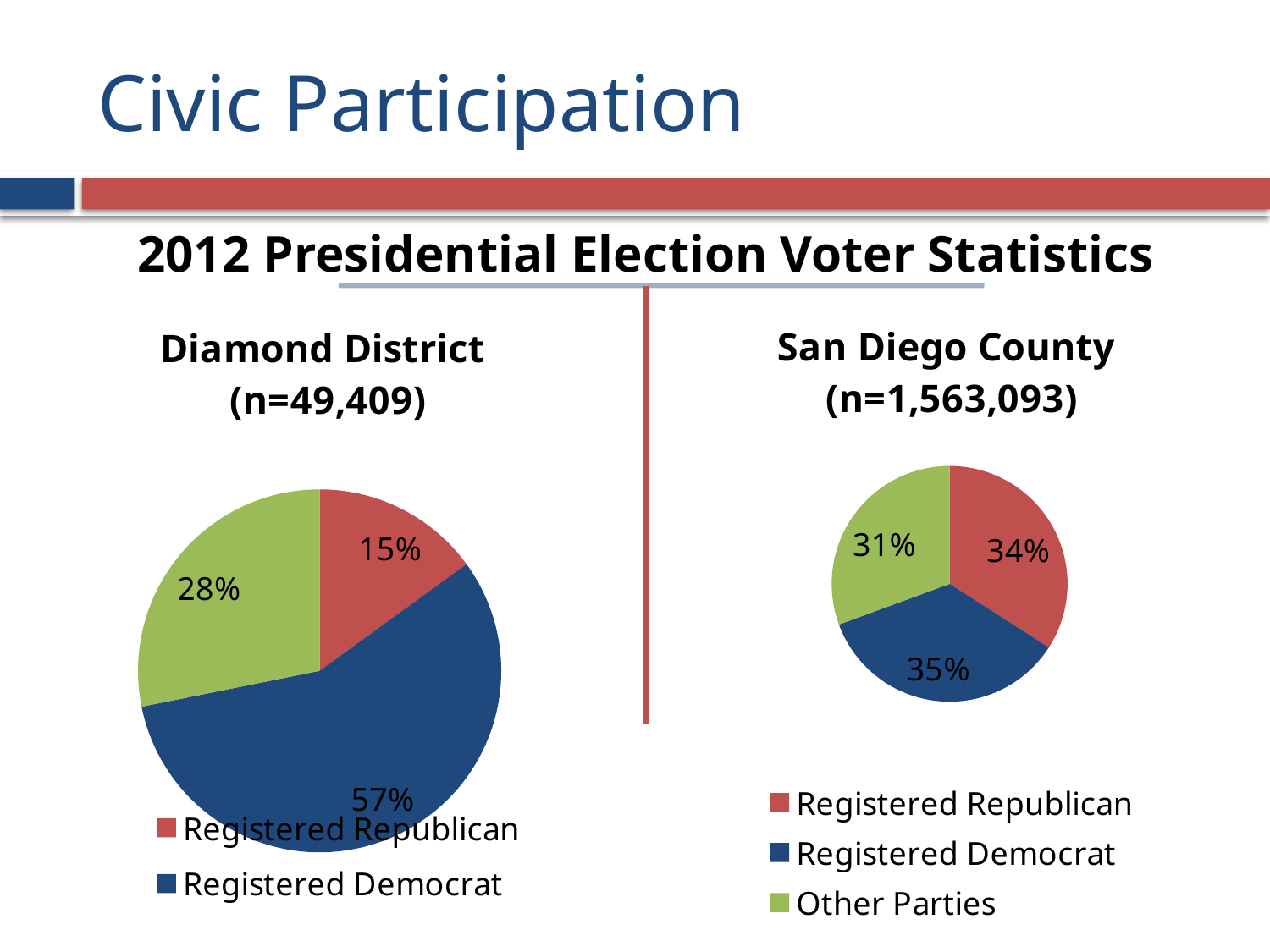
In the Diamond District pie chart, what is the difference in percentage points between Registered Democrat and Registered Republican? 42 What type of chart is used for the San Diego County data? Pie chart In the Diamond District pie chart, what share of voters are Registered Republican? 15% How many entries does the legend of the San Diego County chart list? 3 In the Diamond District pie chart, what share of voters are Registered Democrat? 57% In the San Diego County pie chart, what is the difference in percentage points between Registered Democrat and Other Parties? 4 In the Diamond District pie chart, which category has the smallest slice? Registered Republican In the San Diego County pie chart, what share of voters are Registered Republican? 34% In the San Diego County pie chart, what share of voters are Registered Democrat? 35% In the Diamond District pie chart, which category has the largest slice? Registered Democrat Which chart shows a larger share for Registered Republican, Diamond District or San Diego County? San Diego County In the San Diego County pie chart, what share of voters are Other Parties? 31%